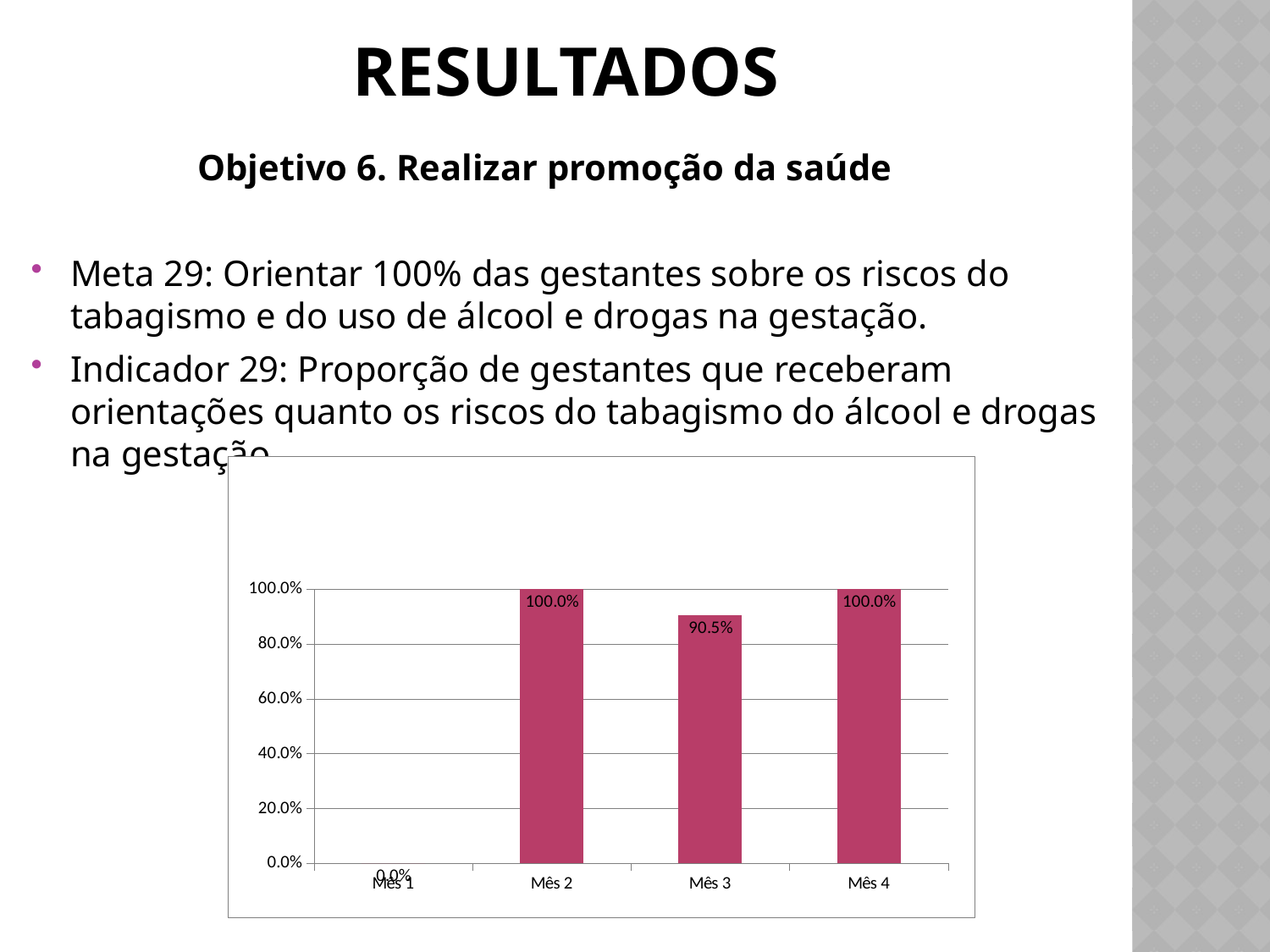
Which is larger, the value for Mês 3 or the value for Mês 4? Mês 4 What is the difference between the values for Mês 4 and Mês 1? 100.0% What is the value for Mês 2? 100.0% Which month has the lowest value? Mês 1 What kind of chart is shown on the slide? bar chart What colour are the bars in the chart? magenta/pink How many months are shown on the x axis? 4 Is the value for Mês 3 greater or less than 80.0%? greater What is the value for Mês 4? 100.0% What is the value for Mês 3? 90.5% What is the difference between the values for Mês 2 and Mês 3? 9.5% What is the value for Mês 1? 0.0%